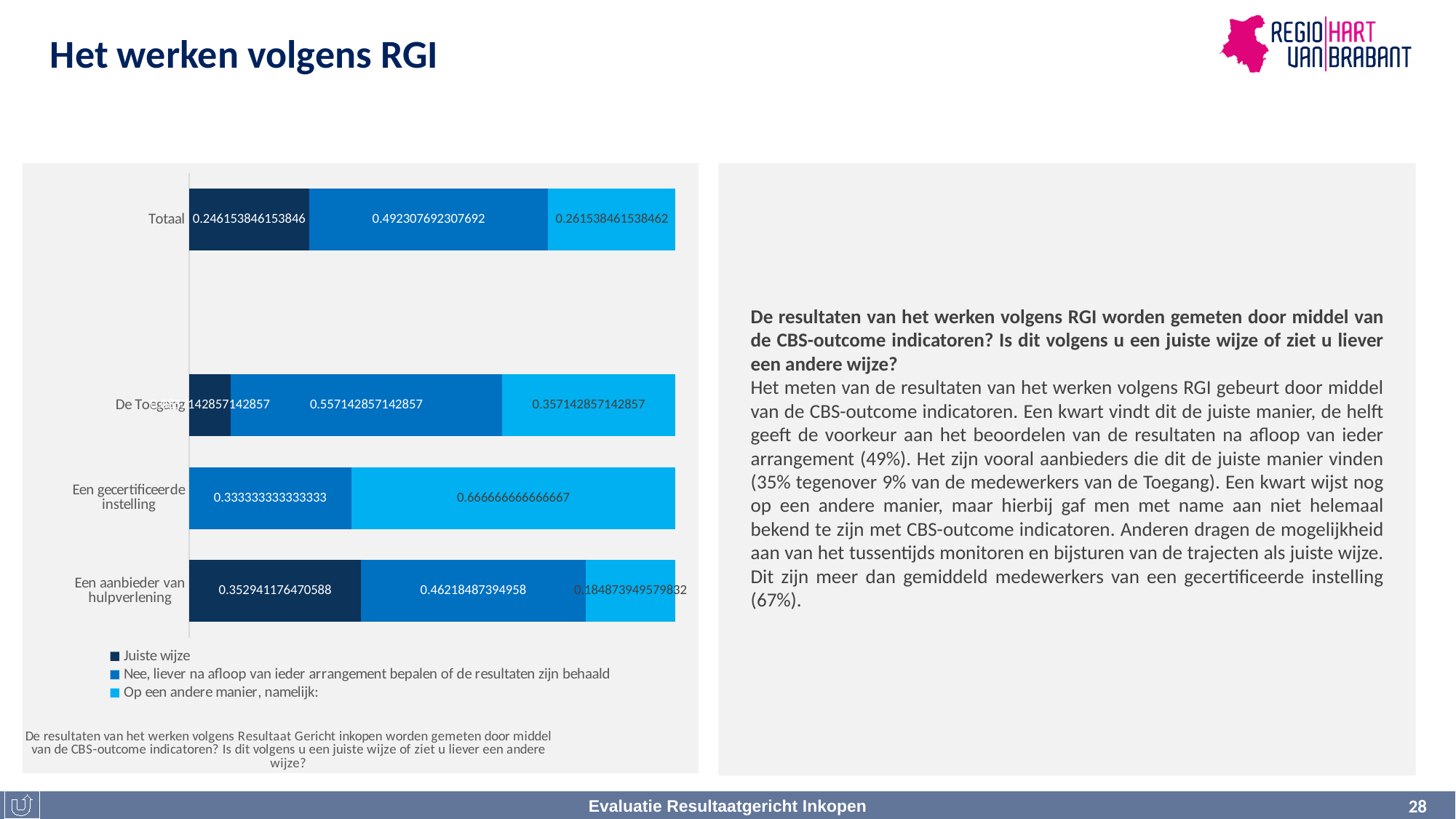
What is the value of 'Op een andere manier, namelijk:' for Een gecertificeerde instelling? 0.666666666666667 What is the value of 'Juiste wijze' for Totaal? 0.246153846153846 What is the value of 'Nee, liever na afloop van ieder arrangement bepalen of de resultaten zijn behaald' for Totaal? 0.492307692307692 Is the 'Nee, liever na afloop van ieder arrangement bepalen of de resultaten zijn behaald' value larger for De Toegang or for Een aanbieder van hulpverlening? De Toegang Which series is shown in the lightest blue colour in the legend? Op een andere manier, namelijk: How many categories are plotted on the chart? 4 What kind of chart is shown on the slide? stacked bar chart What is the value of 'Op een andere manier, namelijk:' for De Toegang? 0.357142857142857 How many series does the chart legend list? 3 What is the value of 'Juiste wijze' for Een aanbieder van hulpverlening? 0.352941176470588 Which category has the highest value for 'Juiste wijze'? Een aanbieder van hulpverlening Which category has the highest value for 'Op een andere manier, namelijk:'? Een gecertificeerde instelling